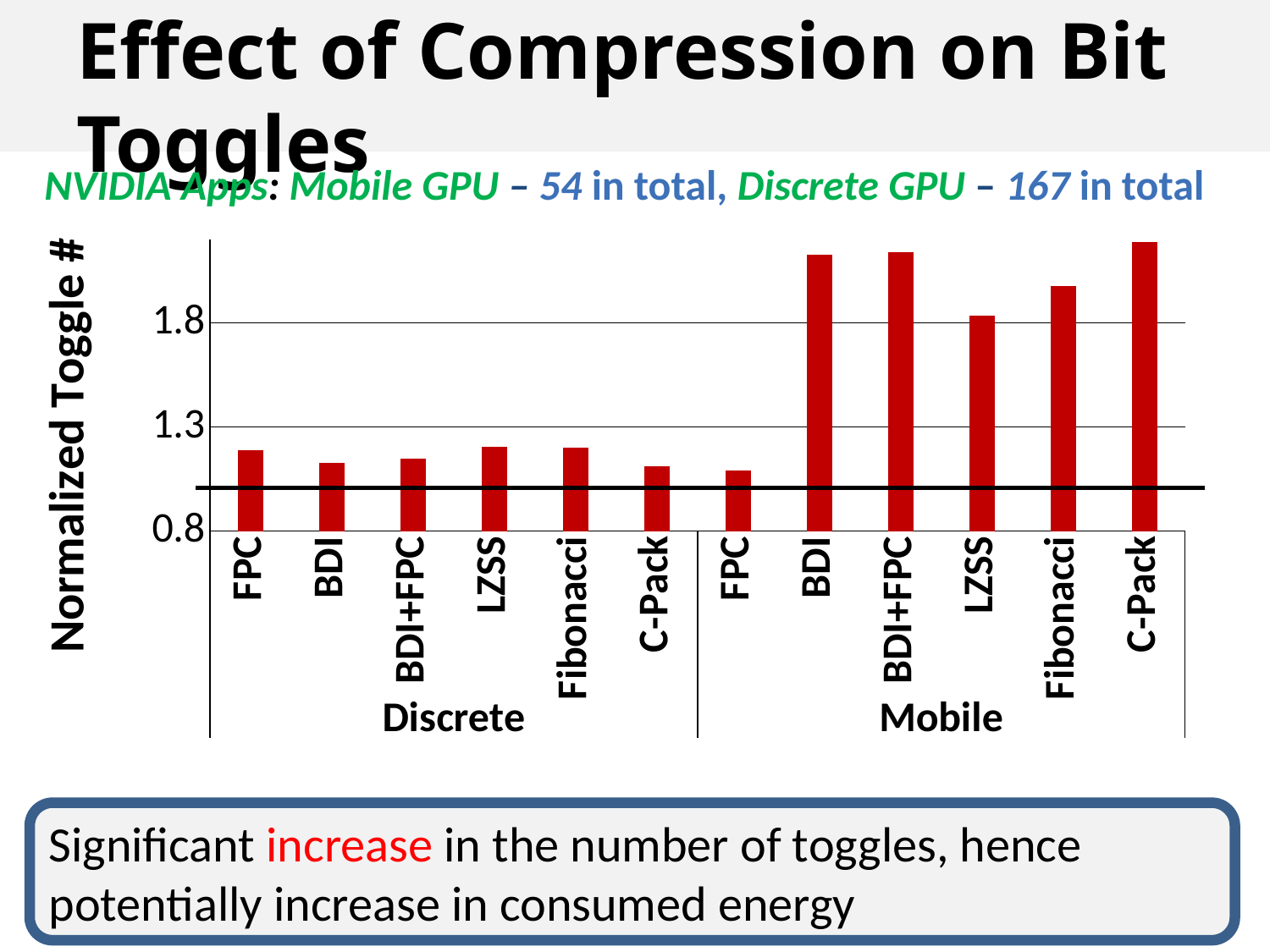
How many bars are plotted in the chart? 12 Is the value for BDI in the Mobile group greater or less than 1.8? greater What kind of chart is shown on the slide? bar chart What are the two group labels shown along the x axis? Discrete and Mobile Is the value for LZSS in the Discrete group greater or less than 1.3? less Which is larger, the value for Fibonacci in the Mobile group or the value for LZSS in the Mobile group? Fibonacci in the Mobile group What is the title of the y axis? Normalized Toggle # How many compression schemes are shown within the Discrete group? 6 Which is larger, the value for BDI in the Mobile group or the value for BDI in the Discrete group? BDI in the Mobile group Is the value for FPC in the Mobile group greater or less than 1.3? less Which compression scheme has the lowest value in the Mobile group? FPC